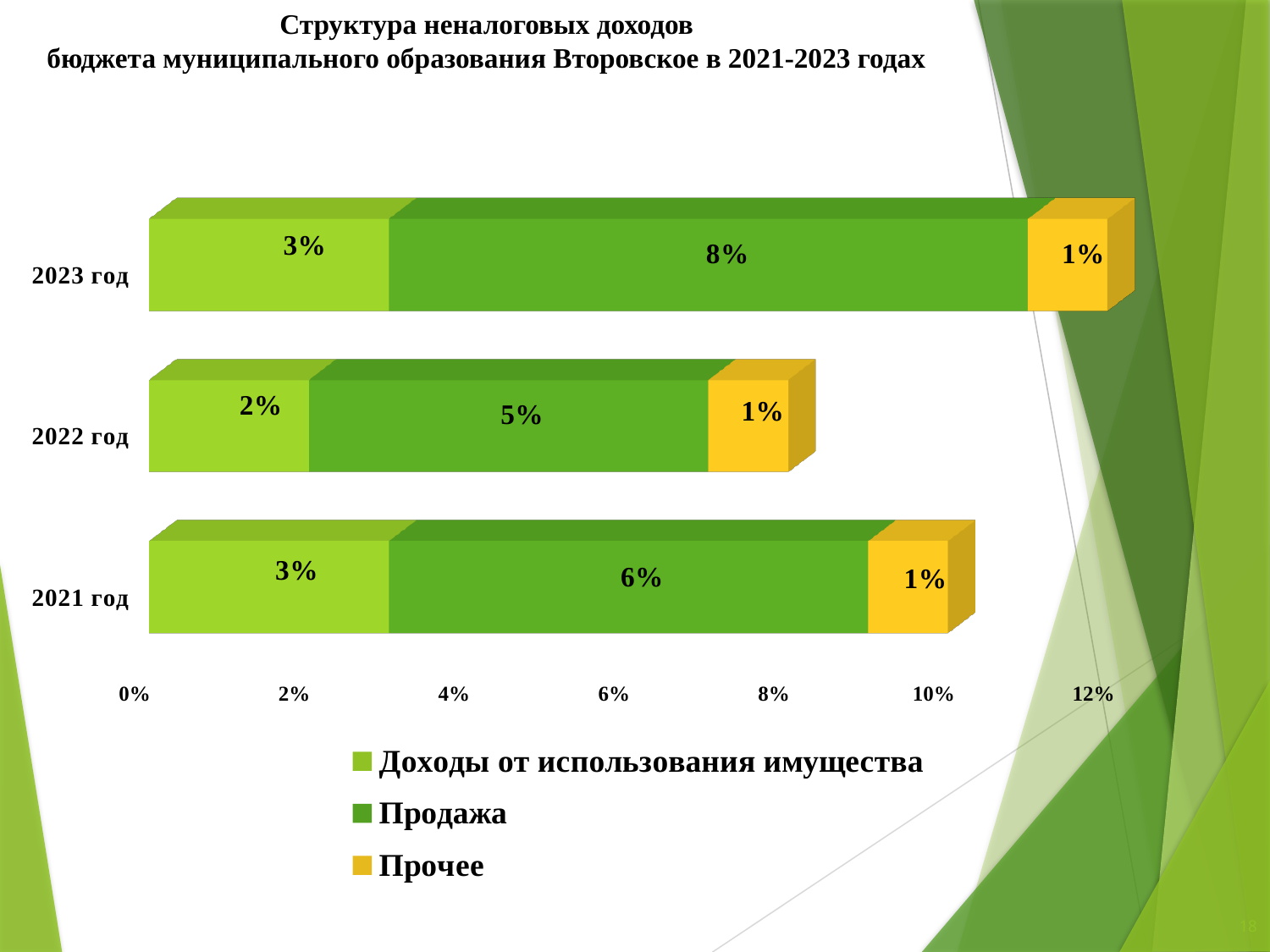
What is the difference between the Продажа values for 2023 год and 2022 год? 3% How many years (categories) are shown on the chart? 3 What is the value for Доходы от использования имущества in 2022 год? 2% In which year is the value for Доходы от использования имущества the lowest? 2022 год In which year is the value for Продажа the highest? 2023 год How many series does the legend list? 3 What is the value for Прочее in 2021 год? 1% What is the total of the stacked bar for 2022 год? 8% Which is larger: Продажа in 2021 год or Продажа in 2022 год? Продажа in 2021 год What is the total of the stacked bar for 2021 год? 10% What is the value for Продажа in 2023 год? 8% What kind of chart is shown on the slide? Stacked bar chart